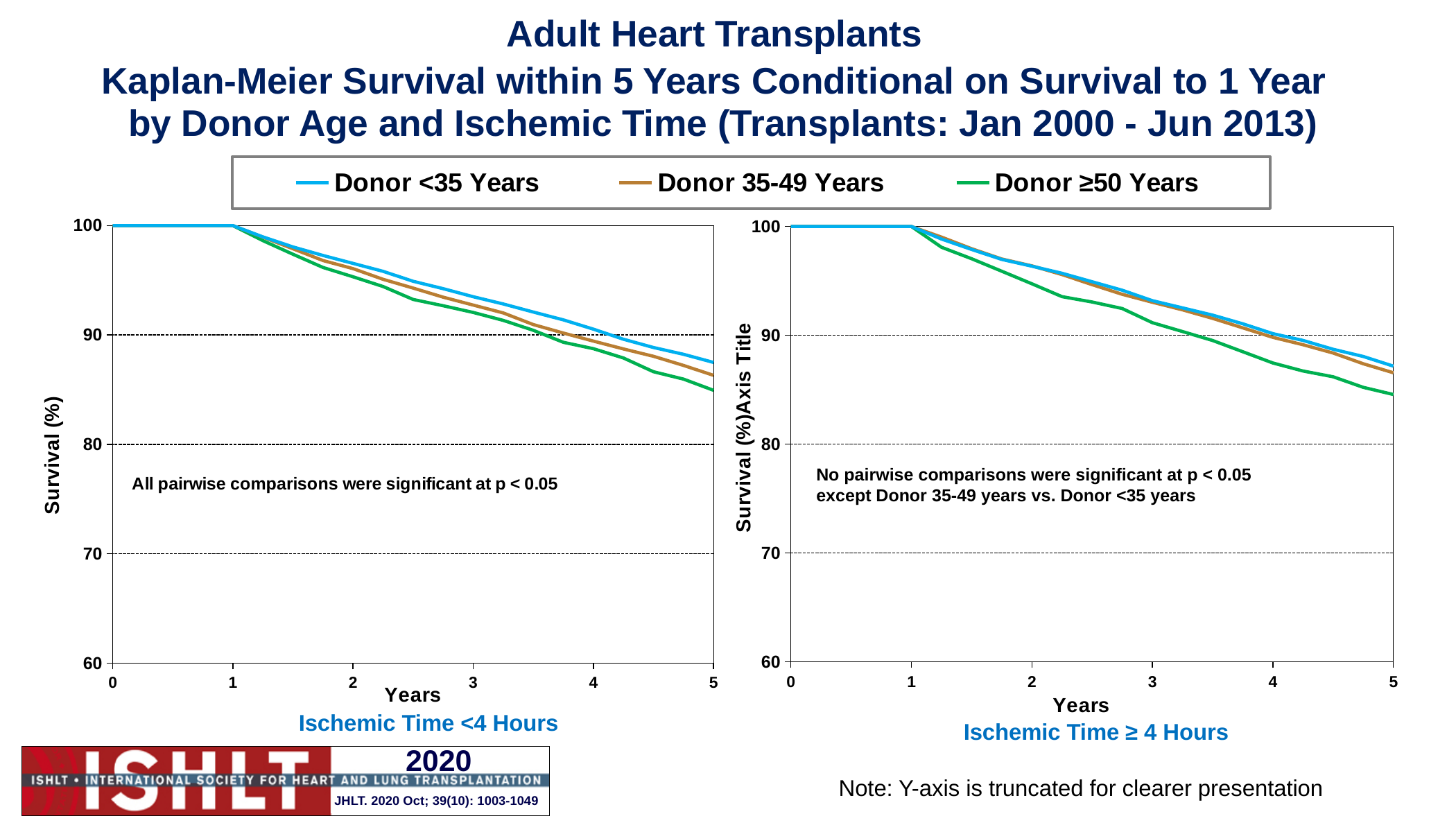
In the 'Ischemic Time ≥ 4 Hours' chart, is the survival value for Donor ≥50 Years at 5 years greater or less than 90? less In the 'Ischemic Time <4 Hours' chart, which donor age group has the highest survival at 5 years? Donor <35 Years In the 'Ischemic Time <4 Hours' chart, does survival for Donor ≥50 Years rise or fall from year 1 to year 5? fall In the 'Ischemic Time ≥ 4 Hours' chart, which is higher at 5 years: survival for Donor <35 Years or Donor ≥50 Years? Donor <35 Years In the 'Ischemic Time ≥ 4 Hours' chart, is the survival value for Donor ≥50 Years at 2 years greater or less than 90? greater What type of chart is the 'Ischemic Time <4 Hours' chart? line chart In the 'Ischemic Time <4 Hours' chart, which donor age group has the lowest survival at 5 years? Donor ≥50 Years How many series does the legend list? 3 In the 'Ischemic Time <4 Hours' chart, is the survival value for Donor <35 Years at 3 years greater or less than 90? greater What colour is the line for Donor 35-49 Years in the legend? brown What is the x-axis label on the 'Ischemic Time <4 Hours' chart? Years